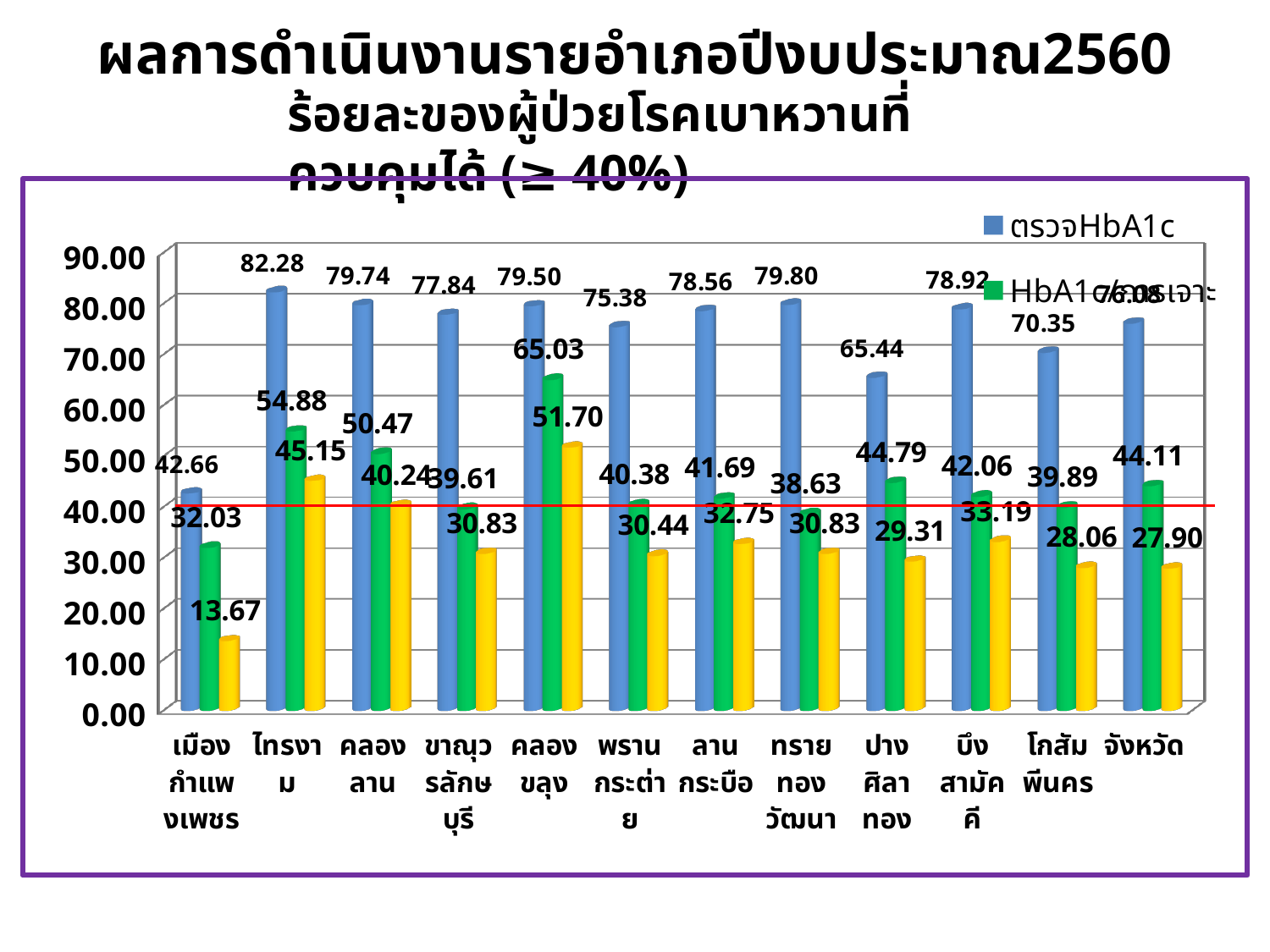
What kind of chart is shown on the slide? bar chart What is the value of the green bar for จังหวัด? 44.11 What is the difference between the ตรวจHbA1c value and the green bar value for ไทรงาม? 27.40 Which has a larger green bar value, คลองขลุง or ไทรงาม? คลองขลุง Which category has the lowest ตรวจHbA1c value? เมืองกำแพงเพชร Is the ตรวจHbA1c value for ปางศิลาทอง greater or less than 60.00? greater Which category has the highest ตรวจHbA1c value? ไทรงาม How many categories are shown on the x axis? 12 What is the value of the green bar for คลองขลุง? 65.03 Which category has the highest yellow bar? คลองขลุง What is the ตรวจHbA1c value for ไทรงาม? 82.28 What is the value of the yellow bar for เมืองกำแพงเพชร? 13.67